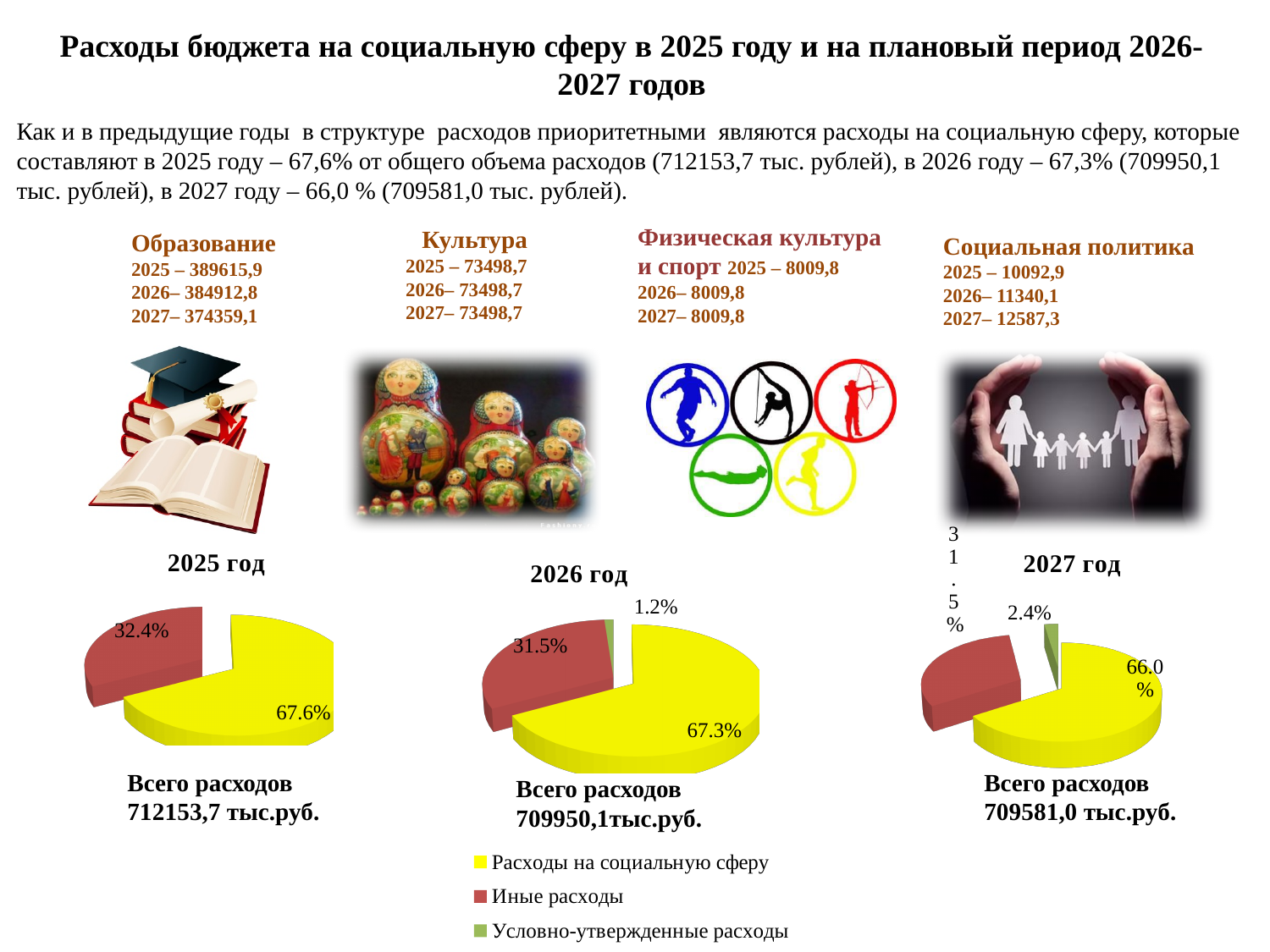
In the "2025 год" pie chart, what is the difference between the shares of Расходы на социальную сферу and Иные расходы? 35.2% In the "2027 год" pie chart, what share is labelled for Расходы на социальную сферу? 66.0% In the "2026 год" pie chart, what share is labelled for Иные расходы? 31.5% How many entries does the shared legend below the pie charts list? 3 In the "2027 год" pie chart, which category has the smallest slice? Условно-утвержденные расходы What type of chart is used for "2026 год"? Pie chart In the "2026 год" pie chart, which category has the largest slice? Расходы на социальную сферу In the "2025 год" pie chart, what share is labelled on the red slice (Иные расходы)? 32.4% In the "2026 год" pie chart, what share is labelled for Условно-утвержденные расходы? 1.2% How many slices does the "2025 год" pie chart have? 2 In the "2025 год" pie chart, what share is labelled on the yellow slice (Расходы на социальную сферу)? 67.6% In the "2027 год" pie chart, what share is labelled for Условно-утвержденные расходы? 2.4%